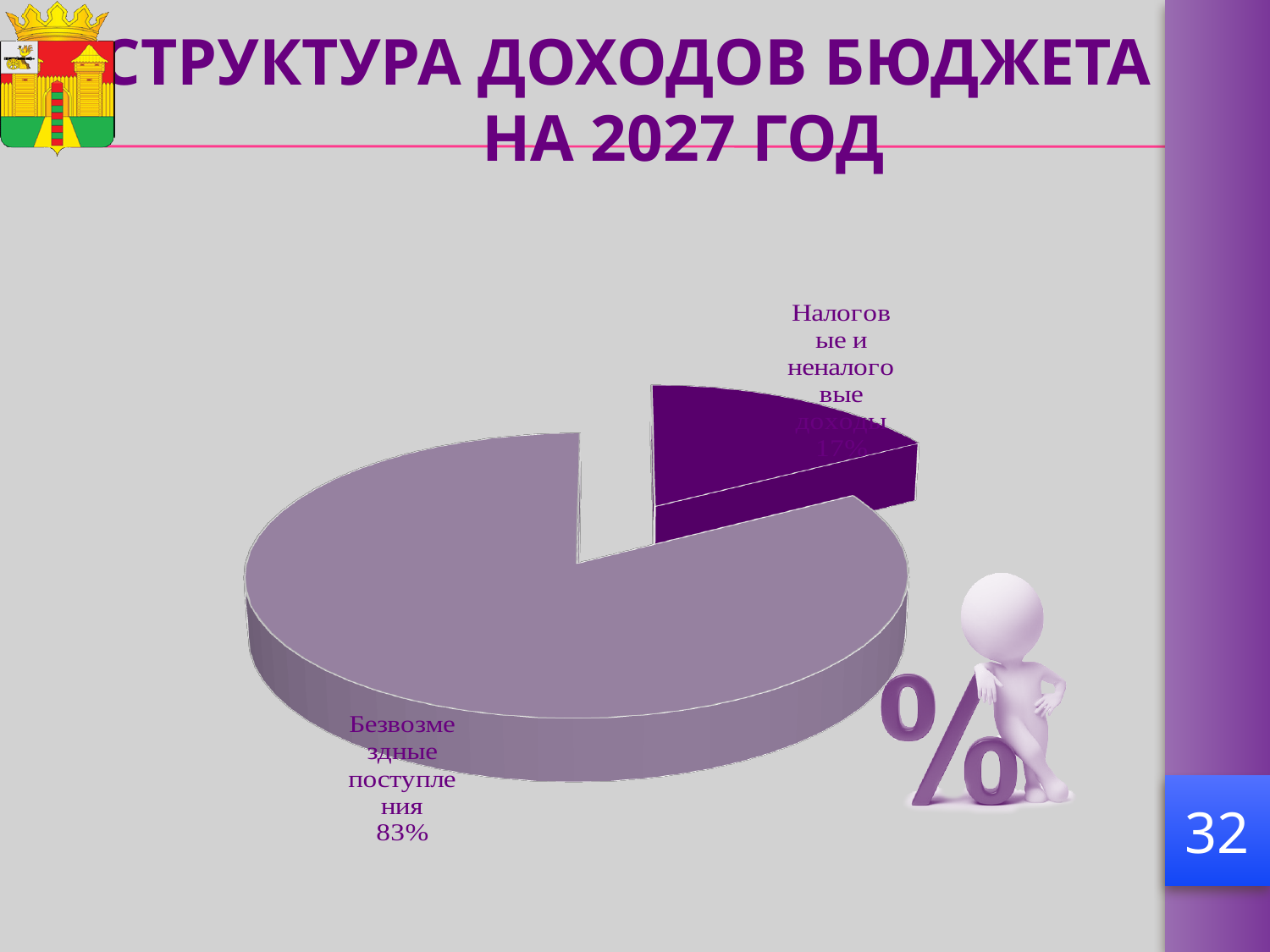
What kind of chart is shown on the slide? pie chart Which slice of the pie chart is the smallest? Налоговые и неналоговые доходы What share of the pie is labelled "Безвозмездные поступления"? 83% How many slices does the pie chart have? 2 Which slice of the pie chart is pulled out (exploded) from the rest of the pie? Налоговые и неналоговые доходы What is the title of the chart on the slide? СТРУКТУРА ДОХОДОВ БЮДЖЕТА НА 2027 ГОД Is the share for "Безвозмездные поступления" greater or less than 50%? greater Is the share for "Налоговые и неналоговые доходы" greater or less than 50%? less Which slice of the pie chart is the largest? Безвозмездные поступления Which is larger: the slice for "Безвозмездные поступления" or the slice for "Налоговые и неналоговые доходы"? Безвозмездные поступления